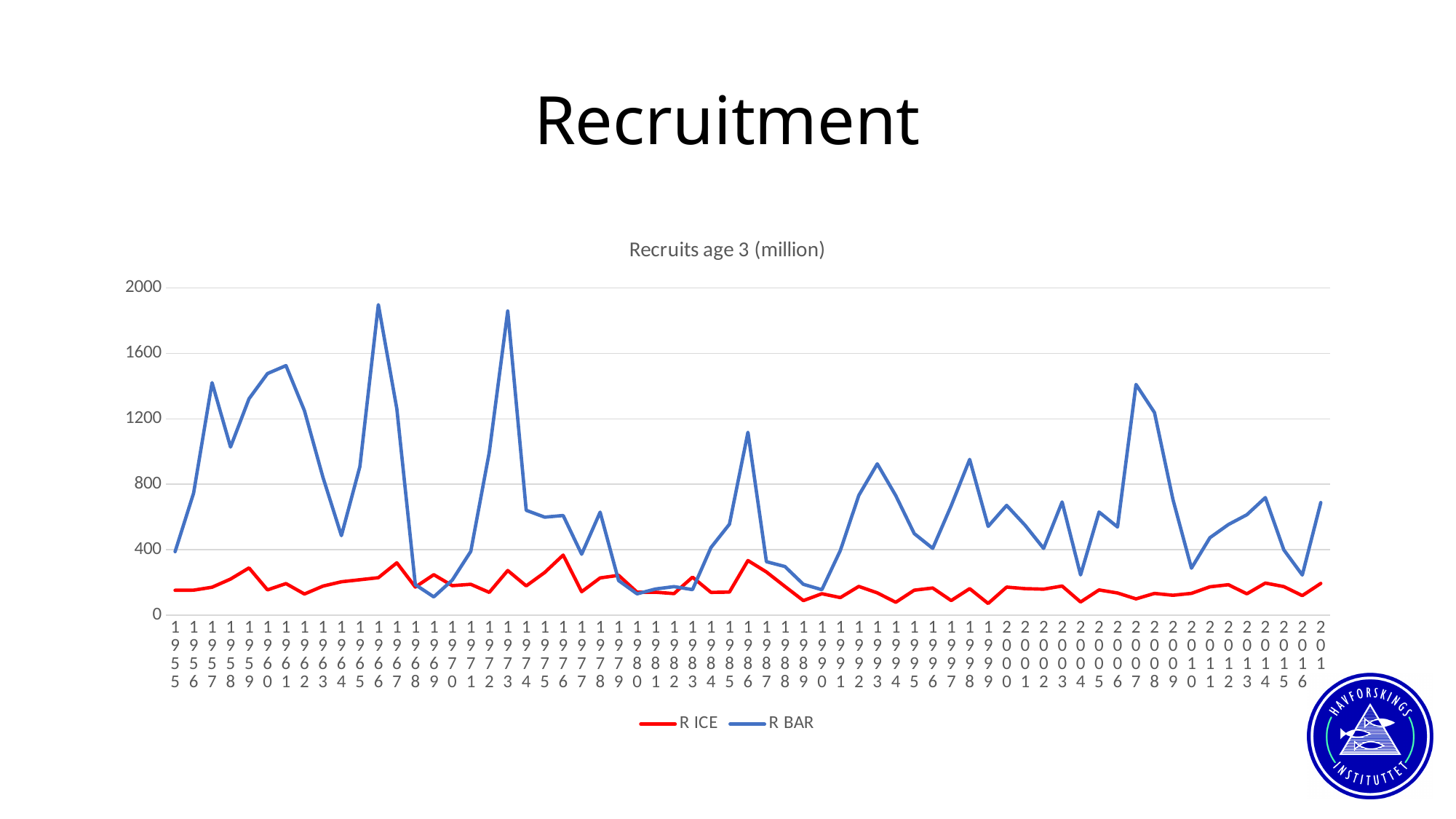
Is the value for R BAR in 2007 greater or less than 1200? greater Does the R BAR series rise or fall from 1966 to 1969? fall How many series does the legend list? 2 How many years are plotted along the x axis? 63 What is the title of the chart? Recruits age 3 (million) What kind of chart is shown on the slide? line chart In 1966, which series has the larger value, R ICE or R BAR? R BAR Is the value for R ICE in 1989 greater or less than 200? less Is the value for R BAR in 1969 greater or less than 400? less Which colour is used for the R BAR series? blue